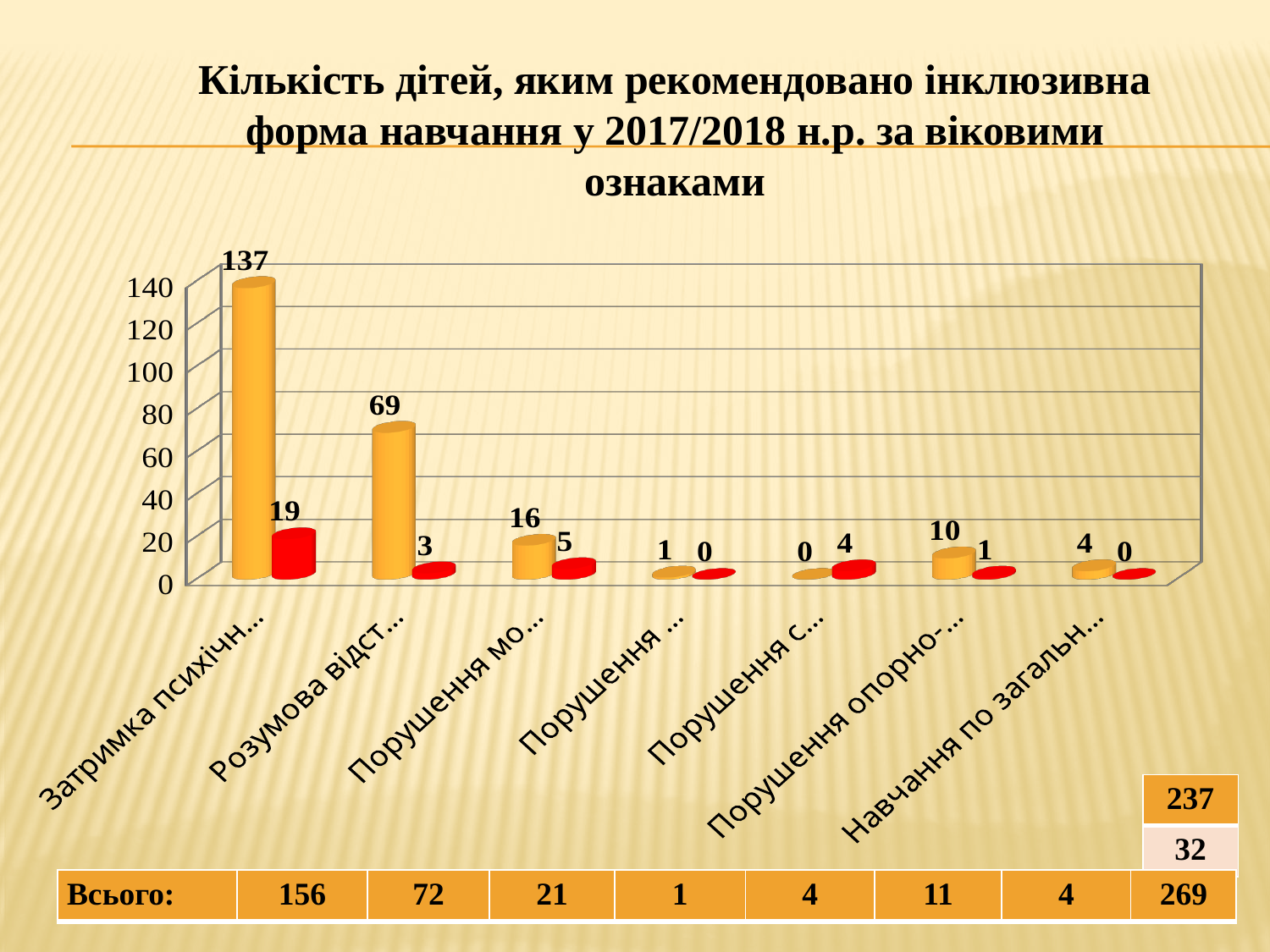
What is the value of the orange bar for the second category, "Розумова відст..."? 69 Which is larger: the orange bar for "Розумова відст..." or the orange bar for "Порушення мо..."? Розумова відст... According to the "Всього:" row below the chart, what is the total for the first category? 156 Is the orange bar for the first category greater or less than 120? greater Which category has the highest orange bar? Затримка психічн... (the first category) How many categories are shown along the x axis of the chart? 7 What kind of chart is shown on the slide? bar chart What is the value of the orange bar for the first category, "Затримка психічн..."? 137 What is the value of the red bar for the first category, "Затримка психічн..."? 19 What is the value of the red bar for the sixth category, "Порушення опорно-..."? 1 What is the value of the orange bar for the third category, "Порушення мо..."? 16 What is the difference between the orange bars of the first category (137) and the second category (69)? 68